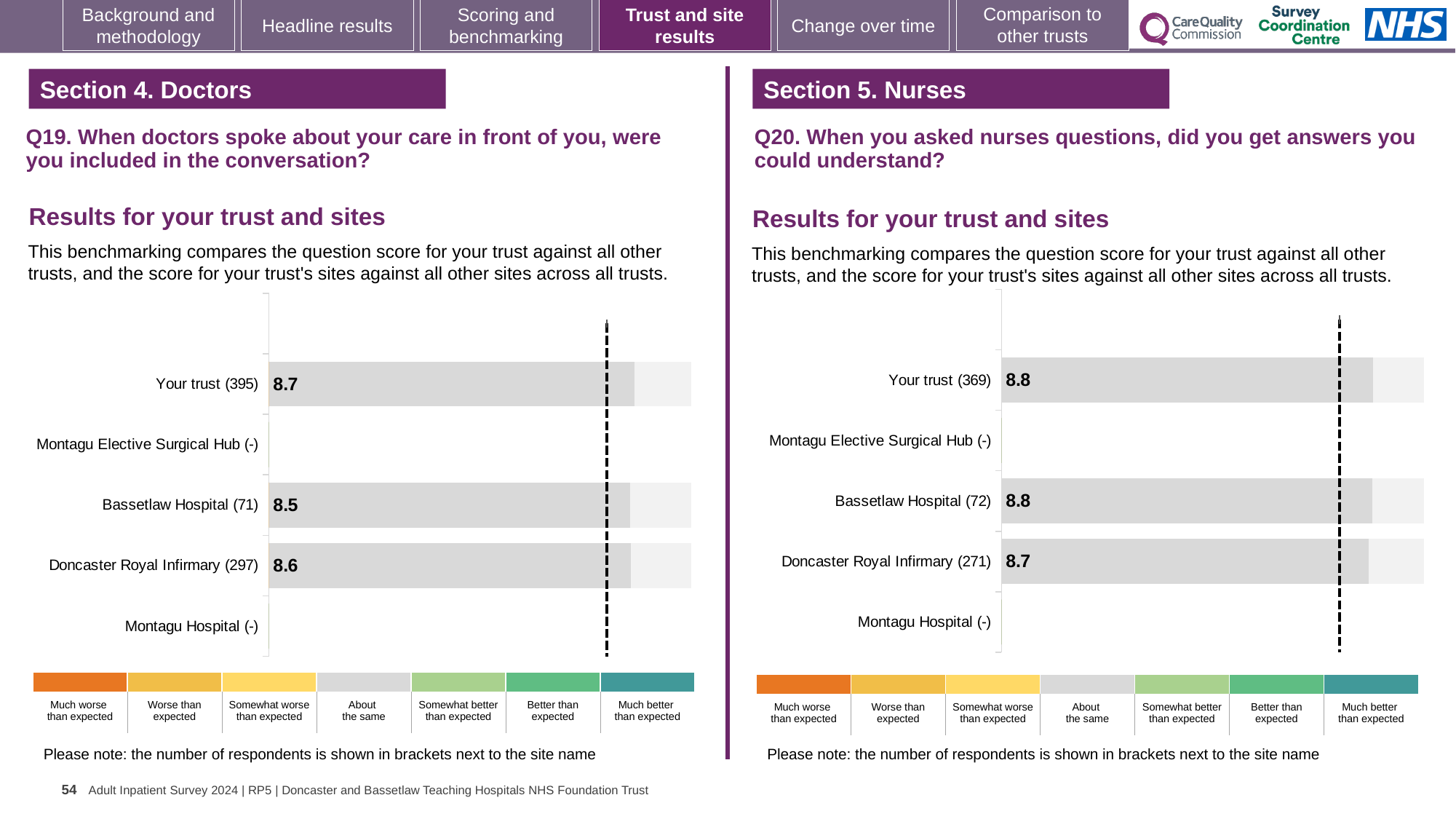
On the Q19 chart (Section 4. Doctors), what is the score for Doncaster Royal Infirmary? 8.6 On the Q20 chart (Section 5. Nurses), what is the score for Doncaster Royal Infirmary? 8.7 On the Q19 chart (Section 4. Doctors), how many site/trust categories are listed on the vertical axis? 5 On the Q20 chart (Section 5. Nurses), what is the difference between the scores for Bassetlaw Hospital and Doncaster Royal Infirmary? 0.1 What kind of chart is used on the Q19 chart (Section 4. Doctors)? Bar chart On the Q20 chart (Section 5. Nurses), what is the score for Your trust? 8.8 On the Q19 chart (Section 4. Doctors), what is the difference between the scores for Your trust and Bassetlaw Hospital? 0.2 On the Q19 chart (Section 4. Doctors), which has the higher score: Doncaster Royal Infirmary or Bassetlaw Hospital? Doncaster Royal Infirmary On the Q19 chart (Section 4. Doctors), what is the score for Bassetlaw Hospital? 8.5 On the Q19 chart (Section 4. Doctors), what is the score for Your trust? 8.7 On the Q19 chart (Section 4. Doctors), which of the labelled bars has the lowest score? Bassetlaw Hospital (71) On the Q20 chart (Section 5. Nurses), how many respondents are shown in brackets for Your trust? 369